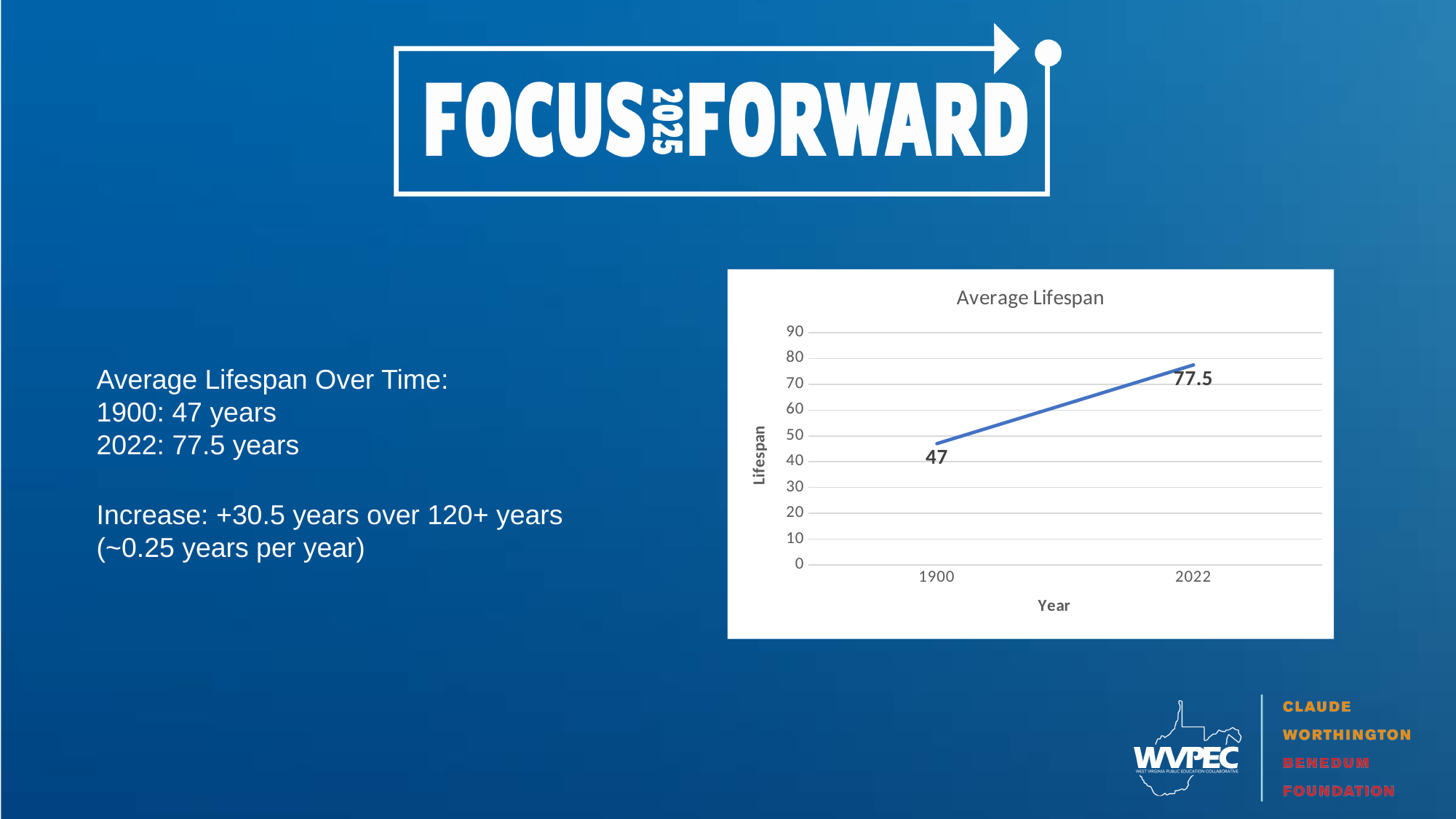
What is the average lifespan value plotted for 1900? 47 What kind of chart is shown on the slide? Line chart Which year shows the lowest average lifespan on the chart? 1900 Which year has the higher average lifespan, 1900 or 2022? 2022 What is the difference between the average lifespan in 2022 and in 1900? 30.5 Is the value for 1900 greater or less than 50? less What is the label on the vertical axis of the chart? Lifespan What is the average lifespan value plotted for 2022? 77.5 Does the average lifespan rise or fall from 1900 to 2022? Rise How many data points are plotted on the chart? 2 What is the title of the chart? Average Lifespan Is the value for 2022 greater or less than 70? greater